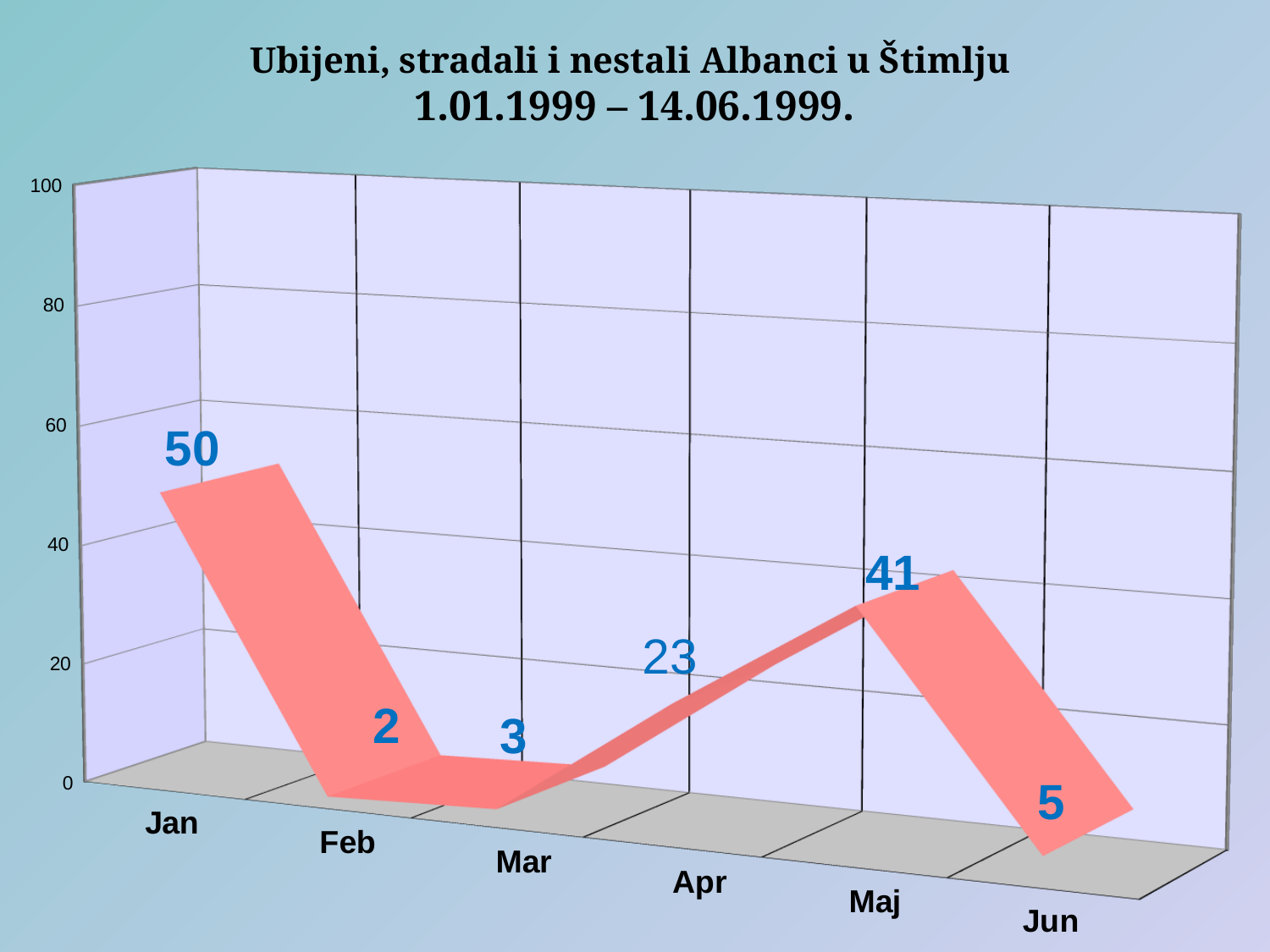
What is the difference between the values for Jan and Maj? 9 Which month has the highest value? Jan What is the value for Maj? 41 What is the title of the chart? Ubijeni, stradali i nestali Albanci u Štimlju 1.01.1999 – 14.06.1999. What is the value for Jan? 50 What kind of chart is this? 3D line (ribbon) chart Do the values rise or fall from Jan to Feb? fall Which is larger, the value for Apr or the value for Jun? Apr How many months are shown on the x axis? 6 What is the value for Jun? 5 What is the value for Apr? 23 Which month has the lowest value? Feb